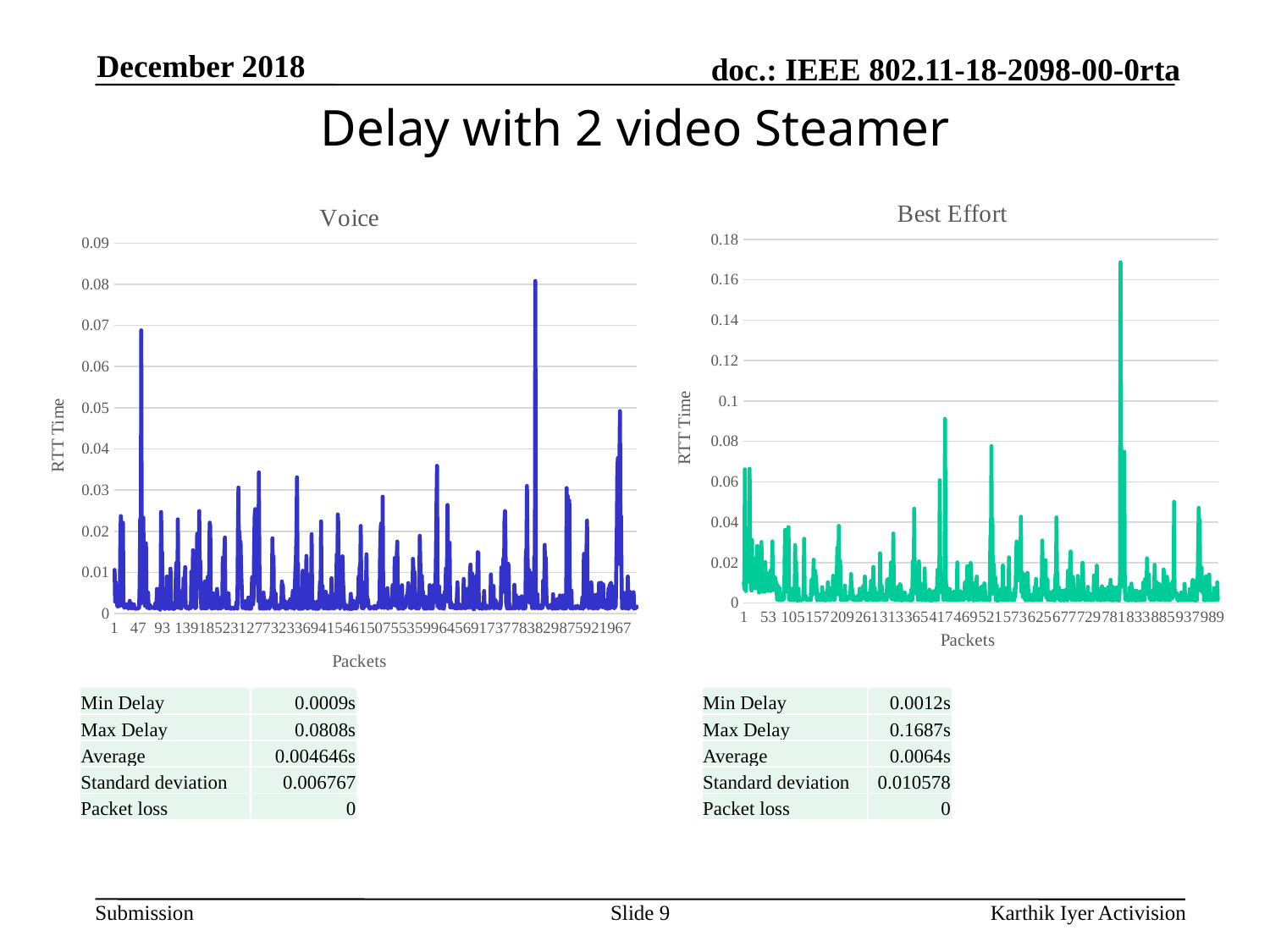
What is the title of the chart on the right of the slide? Best Effort In the Voice chart, is the highest peak greater or less than 0.07 on the RTT Time axis? greater In the Voice chart, is the value at packet 1 greater or less than 0.02? less What kind of chart is the Best Effort chart? line chart What is the title of the chart on the left of the slide? Voice What is the highest tick value shown on the y axis of the Voice chart? 0.09 In the Voice chart, is the second-highest peak (near packet 47) greater or less than 0.06? greater What kind of chart is the Voice chart? line chart Which chart reaches a higher peak RTT Time, Voice or Best Effort? Best Effort What is the highest tick value shown on the y axis of the Best Effort chart? 0.18